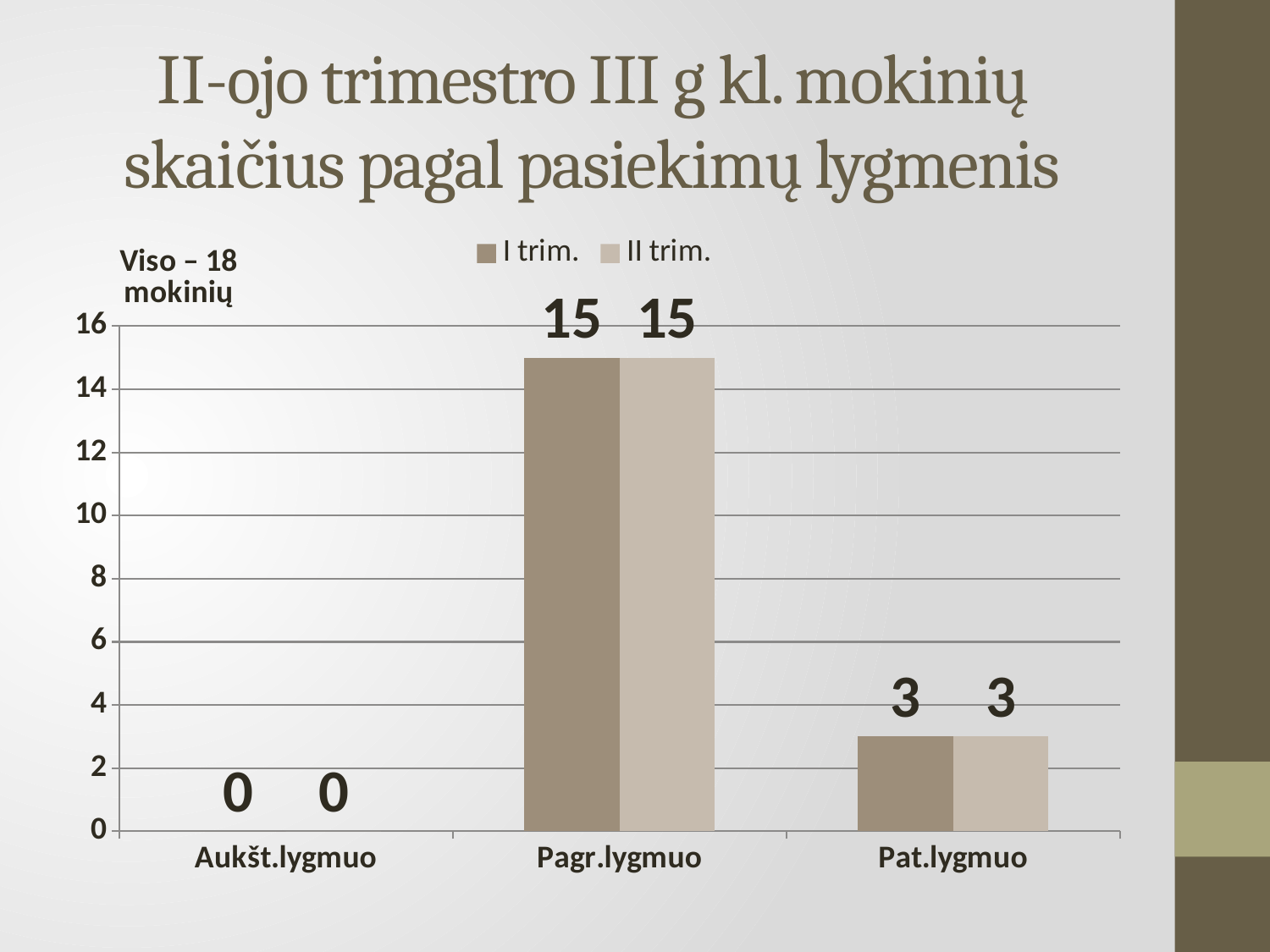
What are the two series names listed in the legend? I trim. and II trim. Which category has the highest value in the II trim. series? Pagr.lygmuo Which is larger in the II trim. series: Pagr.lygmuo or Pat.lygmuo? Pagr.lygmuo Which category has the lowest value in the I trim. series? Aukšt.lygmuo What is the value for Pagr.lygmuo in the I trim. series? 15 How many series does the legend list? 2 What is the difference between the I trim. values for Pagr.lygmuo and Pat.lygmuo? 12 What is the value for Aukšt.lygmuo in the I trim. series? 0 How many categories are shown on the x axis? 3 What is the value for Pat.lygmuo in the II trim. series? 3 What total number of students is stated in the label at the top left of the chart? 18 What kind of chart is shown on the slide? bar chart